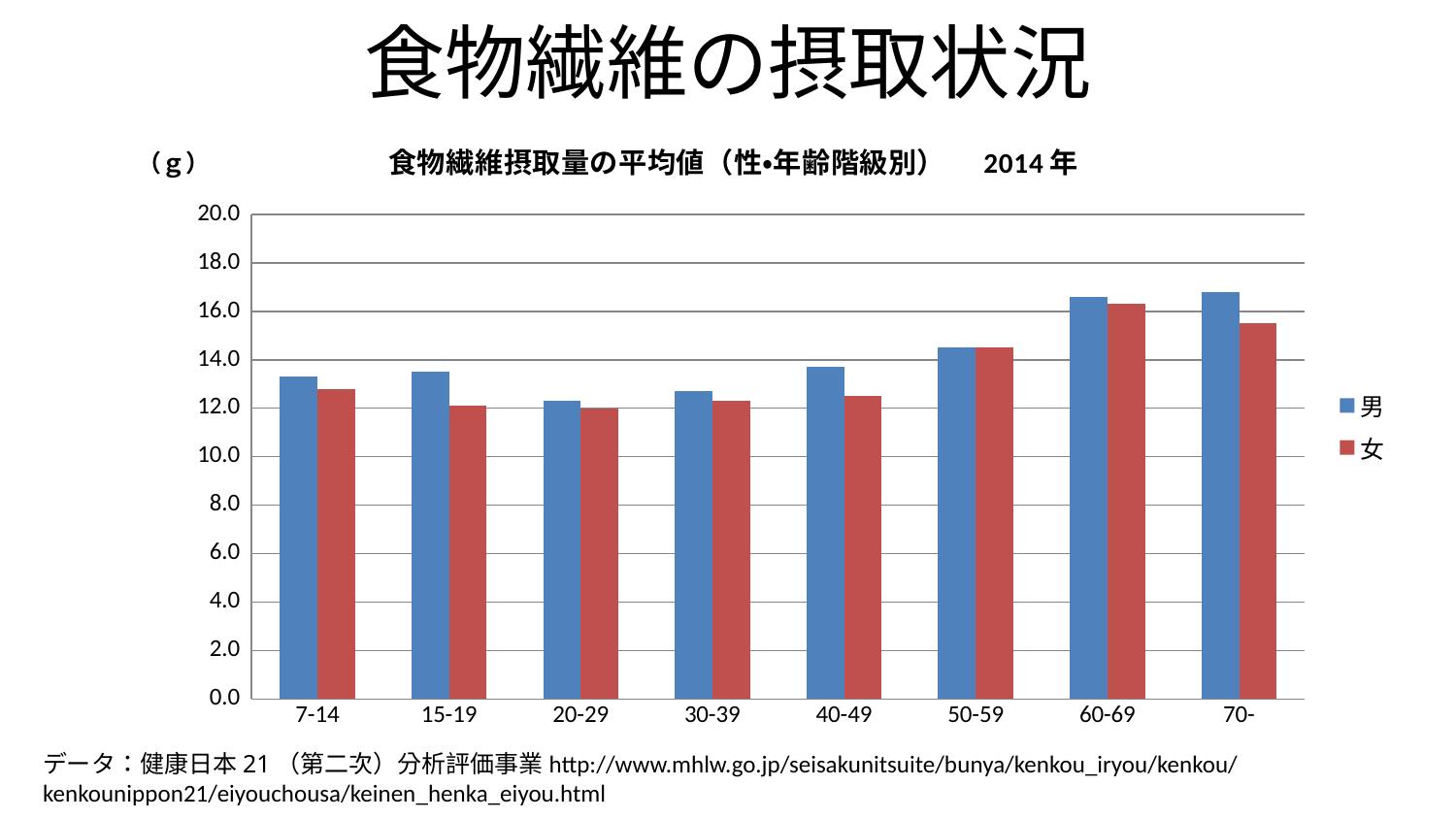
Which age group has the highest value for 男? 70- Is the value for 女 in the 20-29 age group greater or less than 14.0? less How many age groups are shown on the x axis? 8 What unit is shown for the y axis? g For the 70- age group, which is larger, 男 or 女? 男 What kind of chart is shown on the slide? bar chart Is the value for 女 in the 70- age group greater or less than 16.0? less Is the value for 男 in the 60-69 age group greater or less than 16.0? greater Which age group has the highest value for 女? 60-69 How many series does the legend list? 2 What are the two series listed in the legend? 男, 女